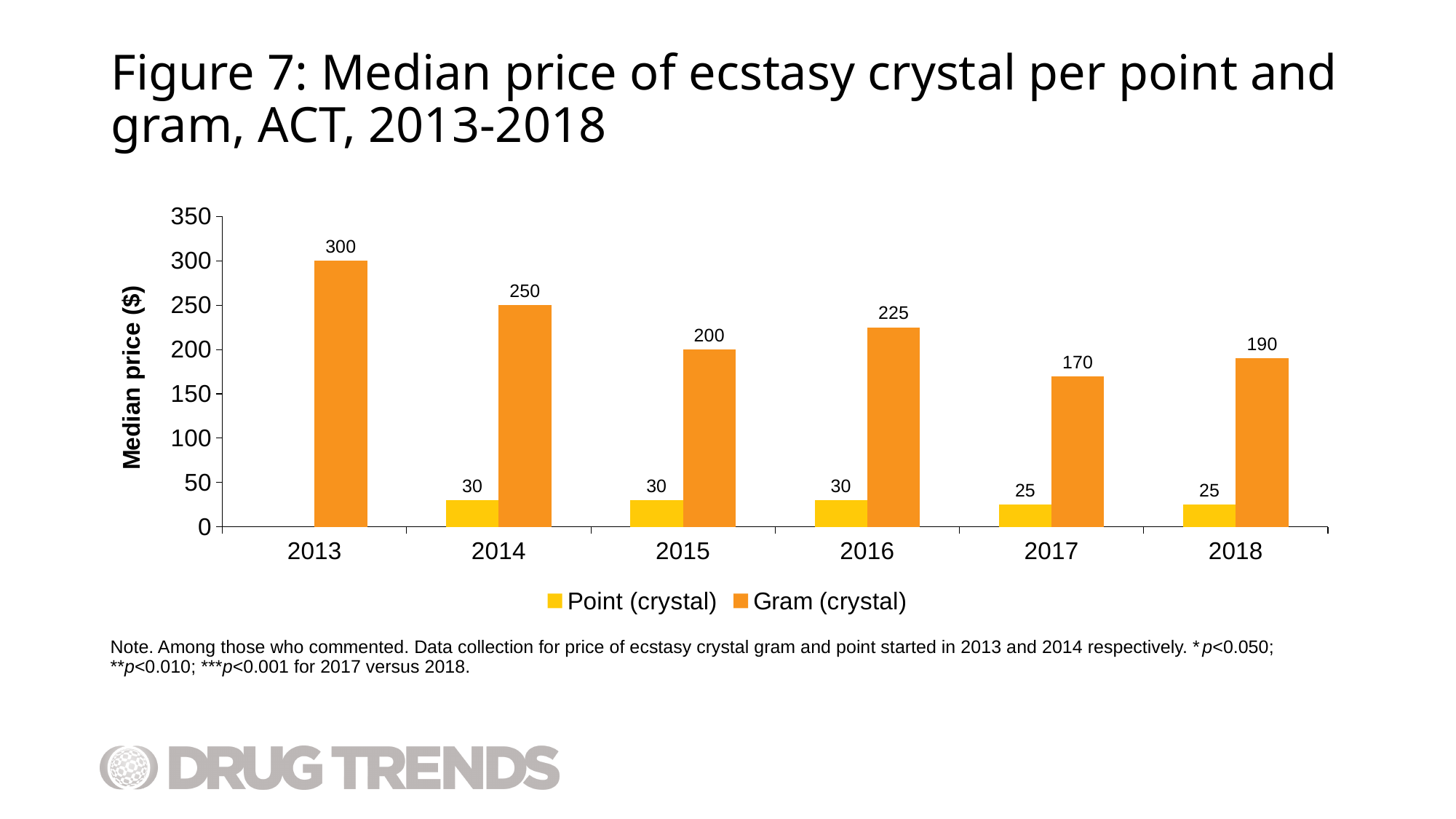
In which year is the median gram price lowest? 2017 How many series does the legend list? 2 How many years are shown on the x axis? 6 What is the median price of a gram of ecstasy crystal in 2016? 225 What kind of chart is shown? bar chart What is the median price of a point of ecstasy crystal in 2017? 25 What is the difference between the median gram price in 2013 and in 2018? 110 What is the label of the y axis? Median price ($) Is the median gram price in 2017 greater or less than 200? less What is the median price of a gram of ecstasy crystal in 2013? 300 In which year is the median gram price highest? 2013 Which is larger, the median gram price in 2015 or in 2016? 2016